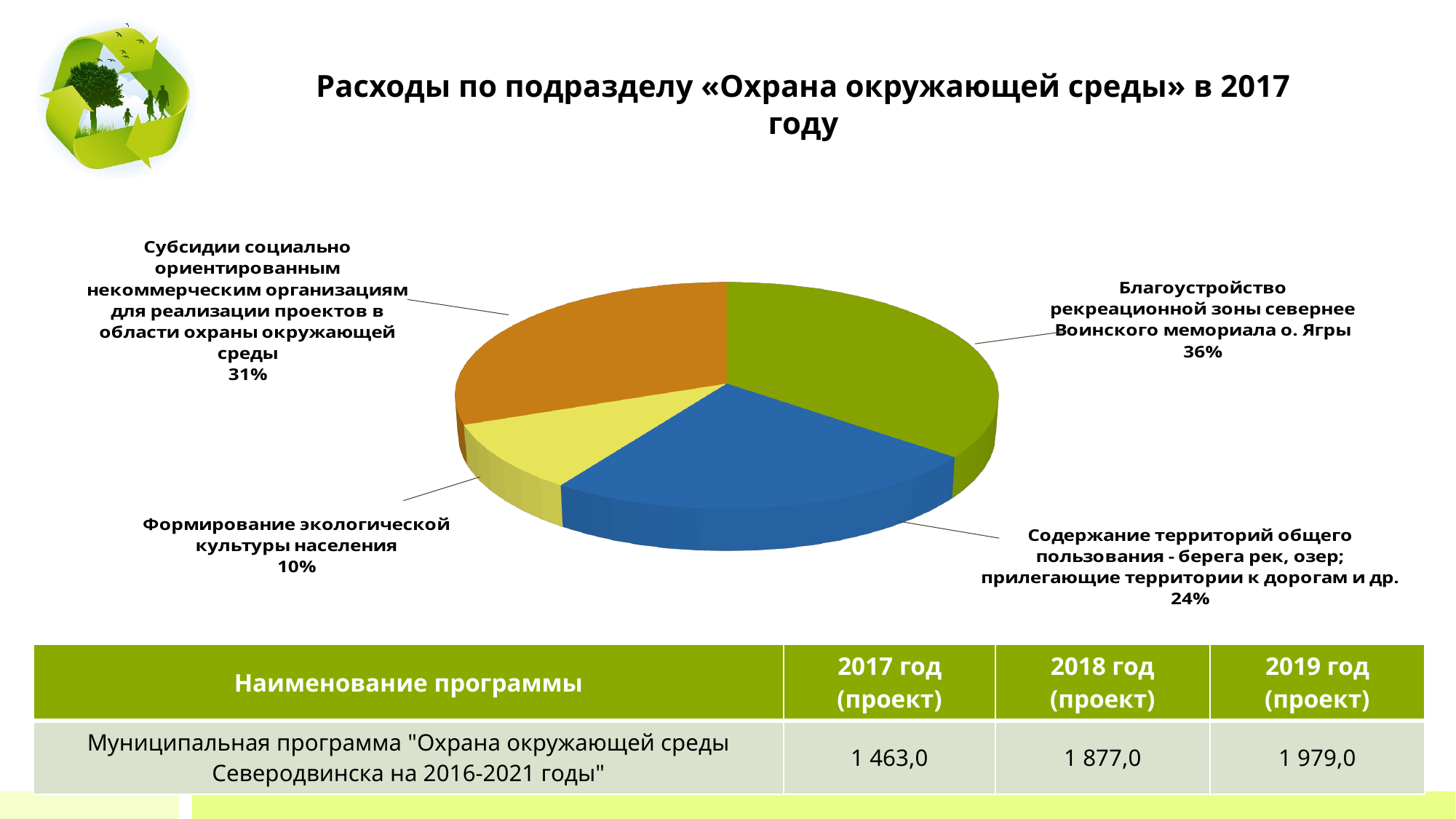
How many slices does the pie chart have? 4 What type of chart is shown on the slide? Pie chart What is the difference in percentage points between the share for «Благоустройство рекреационной зоны севернее Воинского мемориала о. Ягры» and the share for «Содержание территорий общего пользования»? 12 What share of expenses goes to «Содержание территорий общего пользования - берега рек, озер; прилегающие территории к дорогам и др.»? 24% What share of expenses goes to «Благоустройство рекреационной зоны севернее Воинского мемориала о. Ягры»? 36% What colour is the slice for «Содержание территорий общего пользования» in the pie chart? Blue Which category has the smallest share of expenses in the pie chart? Формирование экологической культуры населения Which has a larger share: «Субсидии социально ориентированным некоммерческим организациям» or «Содержание территорий общего пользования»? Субсидии социально ориентированным некоммерческим организациям What is the title of the chart on the slide? Расходы по подразделу «Охрана окружающей среды» в 2017 году What share of expenses goes to «Субсидии социально ориентированным некоммерческим организациям для реализации проектов в области охраны окружающей среды»? 31% What share of expenses goes to «Формирование экологической культуры населения»? 10% Which category has the largest share of expenses in the pie chart? Благоустройство рекреационной зоны севернее Воинского мемориала о. Ягры